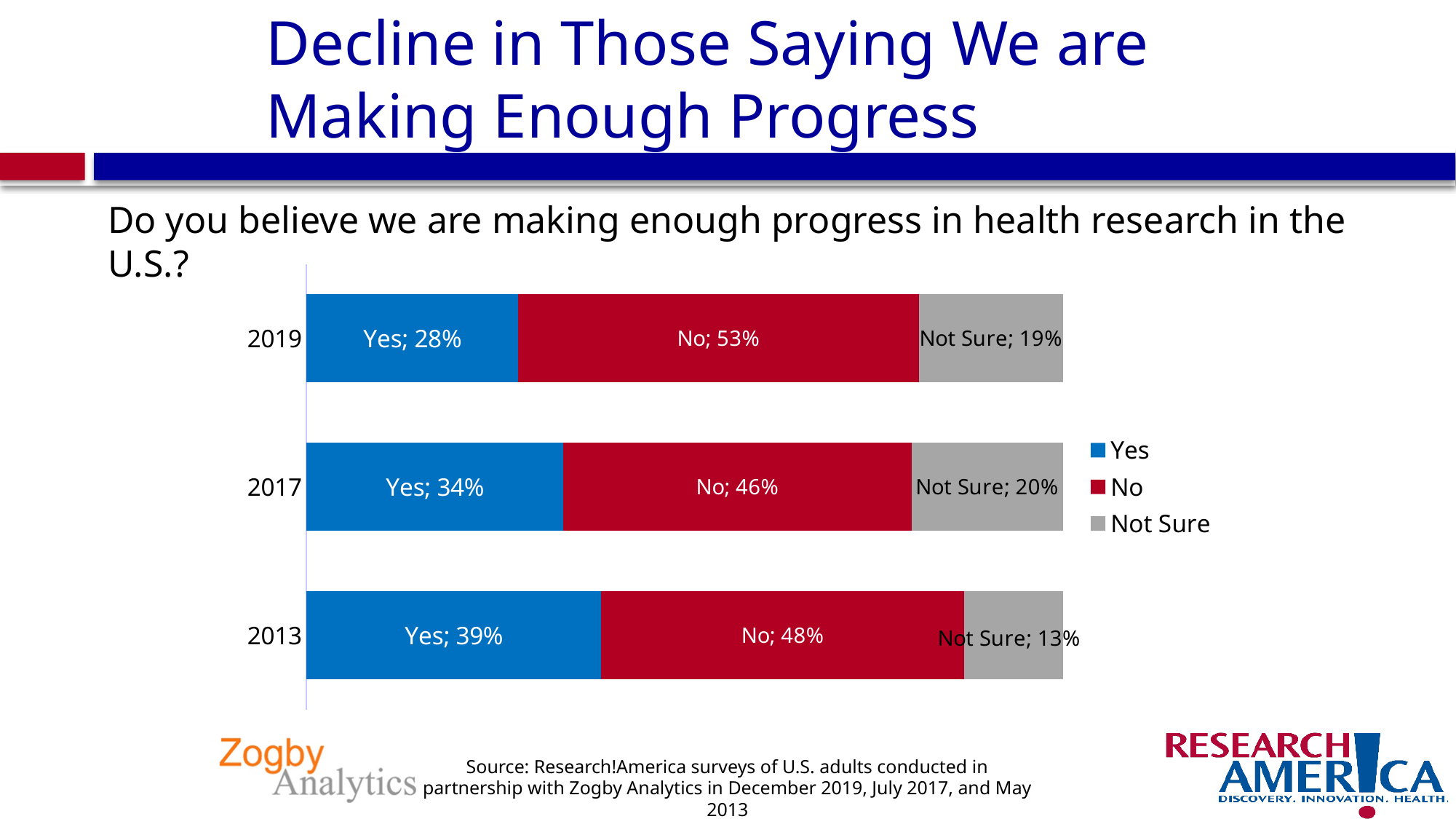
What percentage answered "Yes" in 2019? 28% What percentage answered "Not Sure" in 2013? 13% Does the "Yes" share rise or fall from 2013 to 2019? Fall What is the difference between the "Yes" share in 2013 and in 2019? 11 percentage points In which year was the "Yes" share highest? 2013 How many years are shown in the chart? 3 How many series does the legend list? 3 Which is larger: the "No" share in 2019 or the "No" share in 2013? 2019 What percentage answered "No" in 2017? 46% What kind of chart is shown on the slide? Stacked bar chart In which year was the "Not Sure" share lowest? 2013 Which colour represents the "No" responses in the chart? Red